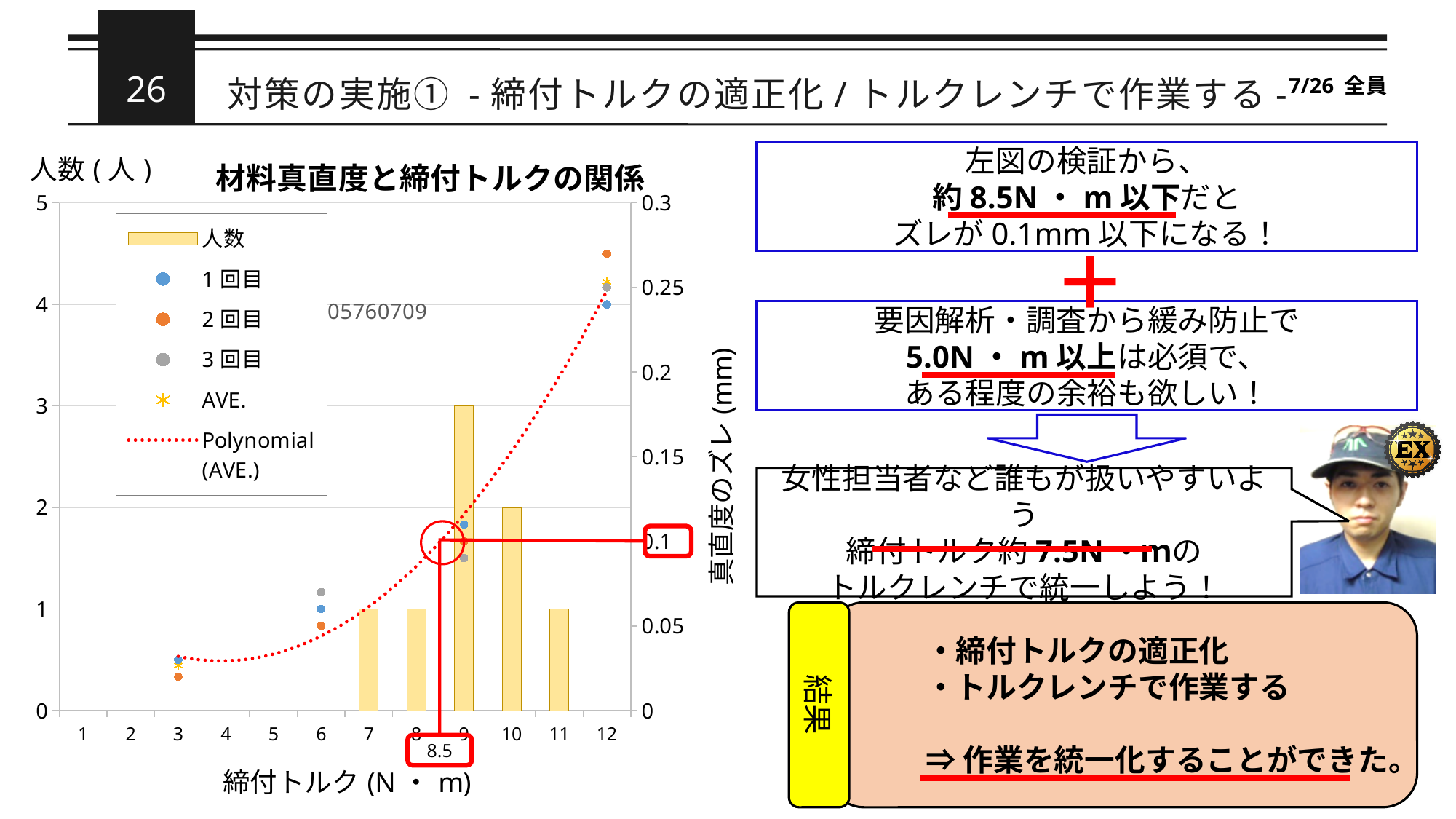
What is the 人数 value at a tightening torque of 9 N・m? 3 What kind of chart is used to plot the 人数 series? bar chart What is the title of the chart? 材料真直度と締付トルクの関係 Is the 2回目 value at torque 12 greater or less than 0.25? greater At which tightening torque is the 人数 bar highest? 9 What is the 人数 value at a tightening torque of 10 N・m? 2 Which has a larger 人数 value: torque 9 or torque 10? 9 What is the label of the right-hand vertical axis? 真直度のズレ (mm) How many tick values are shown on the x axis (締付トルク)? 12 What is the difference between the 人数 values at torque 9 and torque 11? 2 Is the 3回目 value at torque 6 greater or less than 0.05? greater How many series does the chart legend list? 6